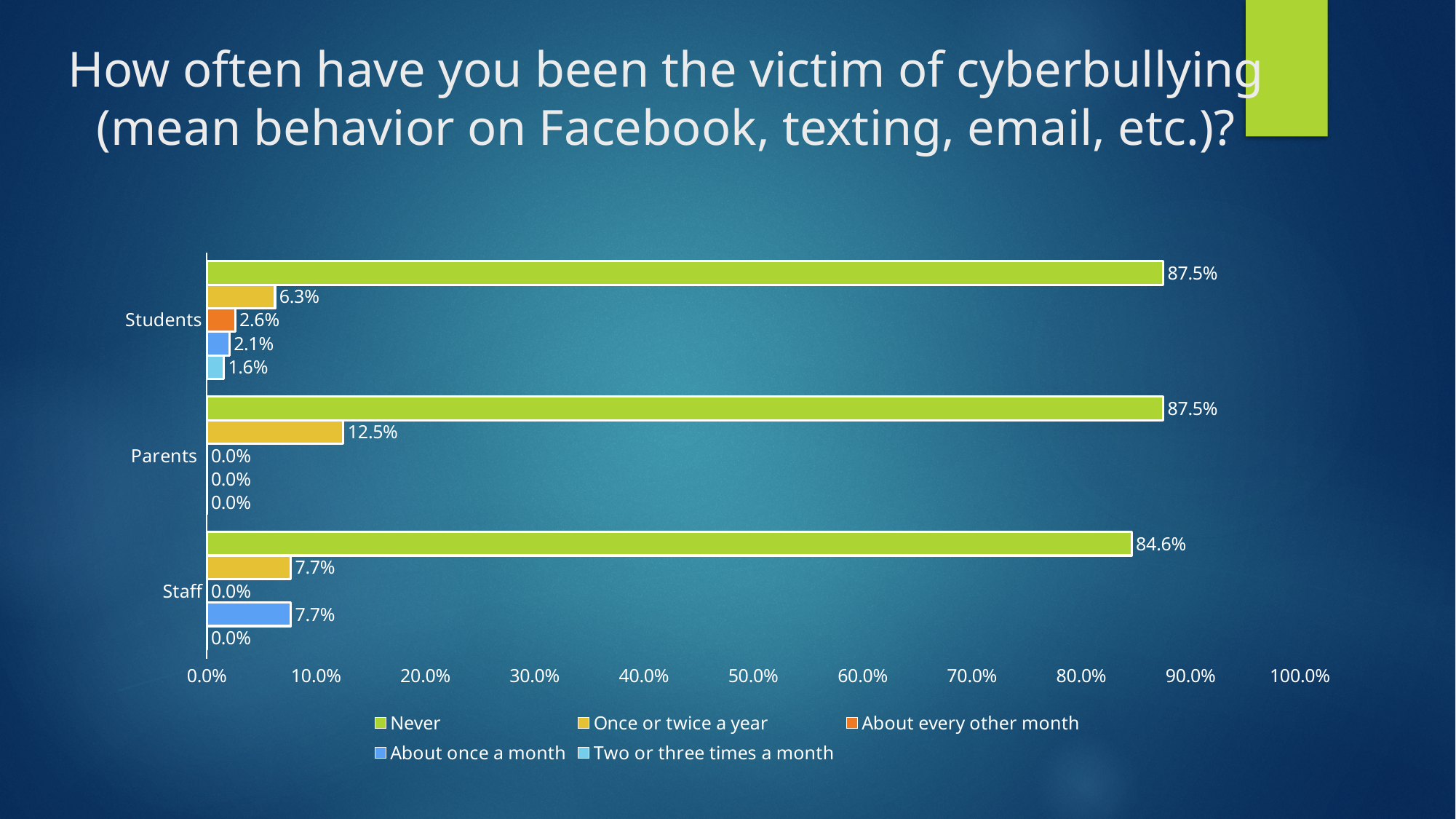
What kind of chart is shown on the slide? Bar chart What is the difference between the "Once or twice a year" values for Parents and Students? 6.2% What percentage of Staff answered "About once a month"? 7.7% What percentage of Parents answered "Once or twice a year"? 12.5% Which group has the highest "Once or twice a year" percentage? Parents What percentage of Students answered "Two or three times a month"? 1.6% How many series does the legend list? 5 Which is larger: the "About every other month" value for Students or for Staff? Students How many groups are shown on the y axis? 3 What percentage of Students answered "Never"? 87.5% Which group has the lowest "Never" percentage? Staff Which colour represents the "Never" series in the legend? Green